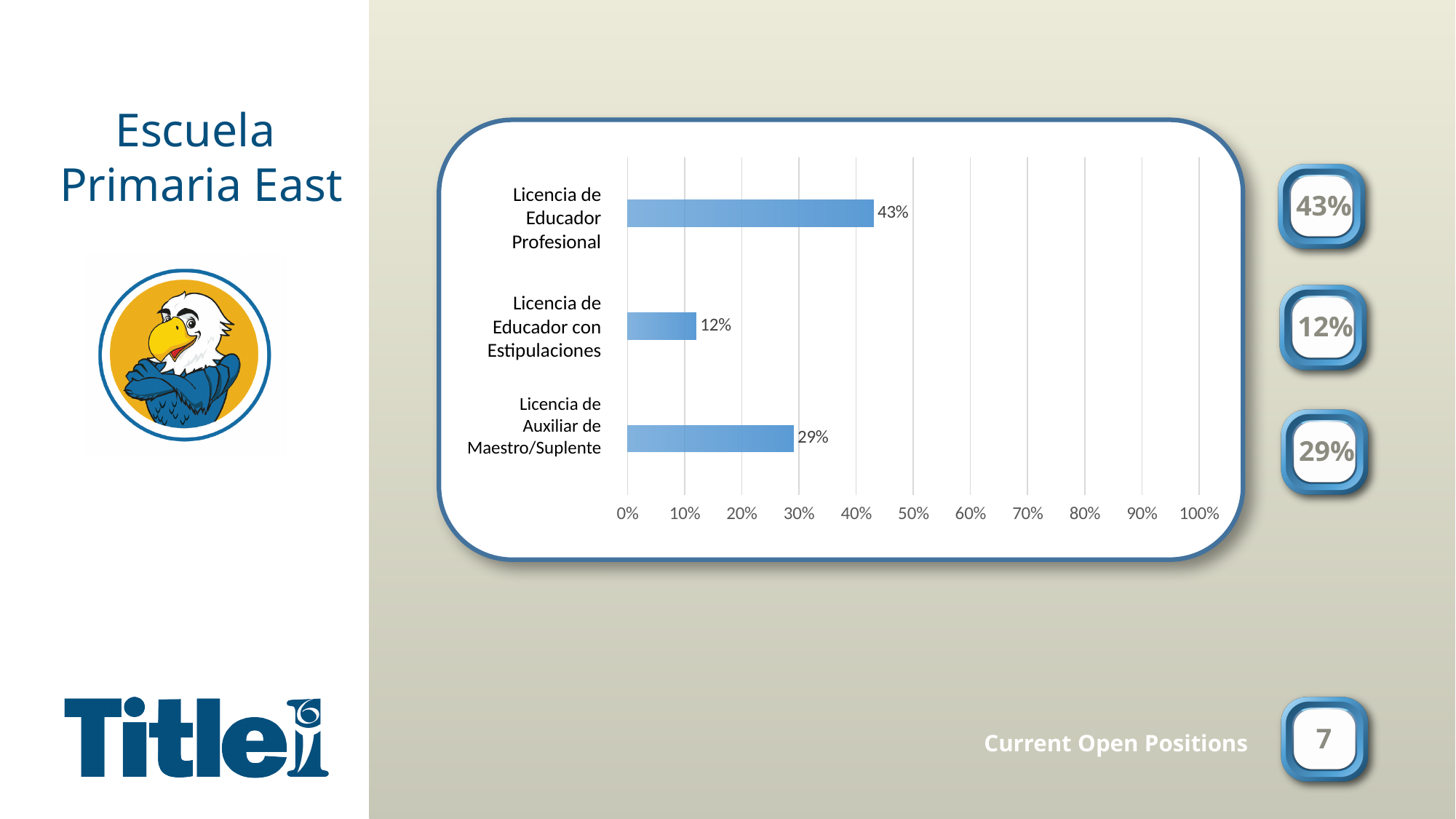
Which category has the highest value? Licencia de Educador Profesional What is the value for Licencia de Educador con Estipulaciones? 12% Is the value for Licencia de Educador Profesional greater or less than 50%? less What is the value for Licencia de Educador Profesional? 43% What is the value for Licencia de Auxiliar de Maestro/Suplente? 29% Which is larger: the value for Licencia de Educador con Estipulaciones or the value for Licencia de Auxiliar de Maestro/Suplente? Licencia de Auxiliar de Maestro/Suplente What kind of chart is shown on the slide? bar chart Which category has the lowest value? Licencia de Educador con Estipulaciones What is the difference between the values for Licencia de Educador Profesional and Licencia de Auxiliar de Maestro/Suplente? 14% How many categories are shown in the chart? 3 What is the difference between the values for Licencia de Auxiliar de Maestro/Suplente and Licencia de Educador con Estipulaciones? 17% What is the maximum value shown on the horizontal axis of the chart? 100%